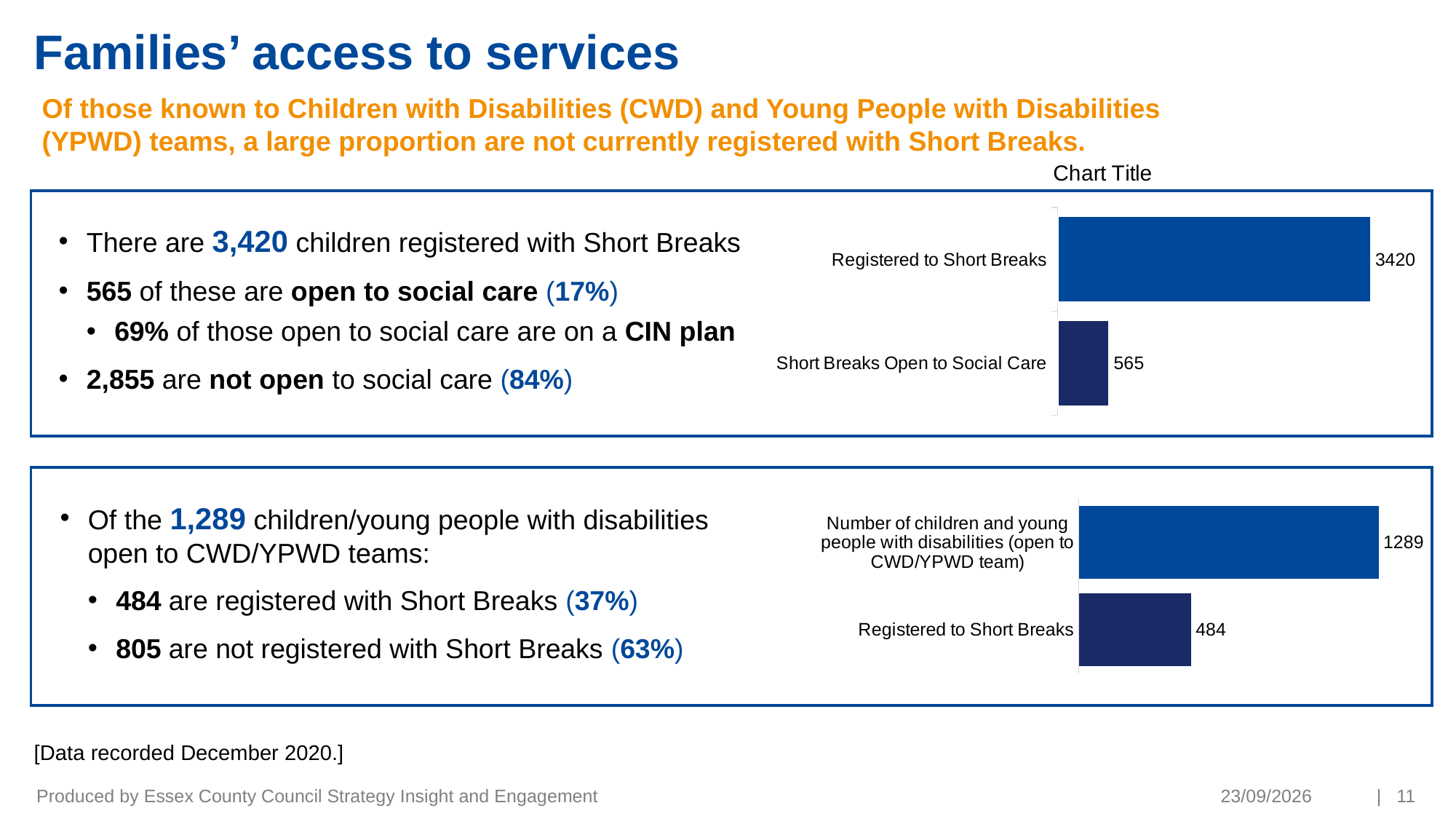
What type of chart is the top chart? Bar chart What is the title shown above the top chart? Chart Title In the bottom chart, what is the difference between the two bars? 805 In the top chart, what is the value for Short Breaks Open to Social Care? 565 In the top chart, how many categories are shown? 2 In the bottom chart, what is the value for Number of children and young people with disabilities (open to CWD/YPWD team)? 1289 In the top chart, what is the value for Registered to Short Breaks? 3420 In the top chart, which category has the highest value? Registered to Short Breaks In the bottom chart, which is larger: Number of children and young people with disabilities (open to CWD/YPWD team) or Registered to Short Breaks? Number of children and young people with disabilities (open to CWD/YPWD team) In the bottom chart, what is the value for Registered to Short Breaks? 484 In the top chart, what is the difference between Registered to Short Breaks and Short Breaks Open to Social Care? 2855 In the bottom chart, which category has the lowest value? Registered to Short Breaks